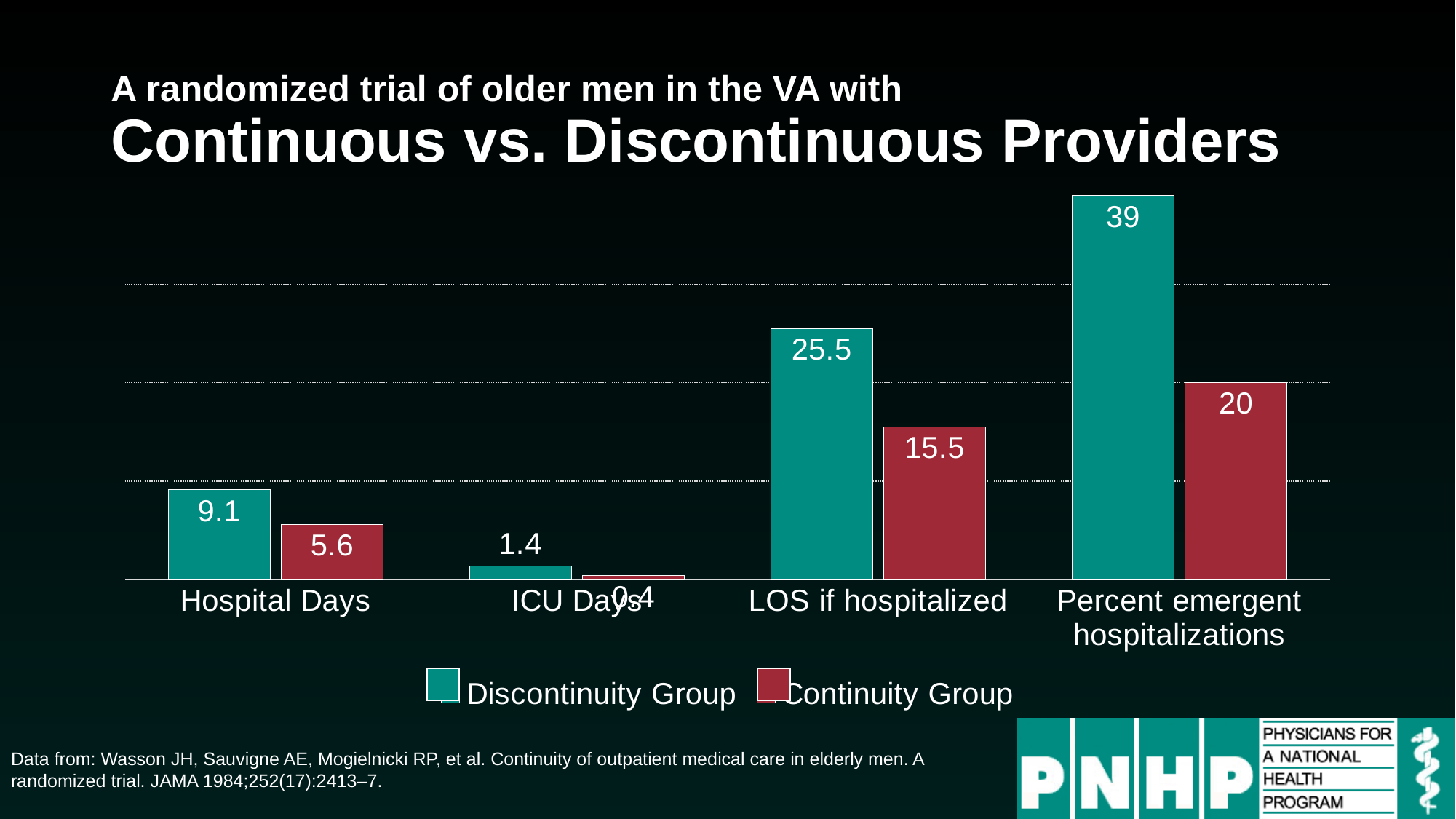
Which category has the highest value for the Discontinuity Group? Percent emergent hospitalizations Which category has the lowest value for the Continuity Group? ICU Days What is the value for the Continuity Group for LOS if hospitalized? 15.5 What is the difference between the Discontinuity Group and Continuity Group values for Percent emergent hospitalizations? 19 What is the value for the Discontinuity Group for ICU Days? 1.4 For LOS if hospitalized, which group has the larger value? Discontinuity Group What is the value for the Discontinuity Group for Hospital Days? 9.1 What is the value for the Continuity Group for Percent emergent hospitalizations? 20 How many categories are shown on the x axis? 4 What kind of chart is shown on the slide? Bar chart What is the difference between the Discontinuity Group and Continuity Group values for Hospital Days? 3.5 How many series does the legend list? 2